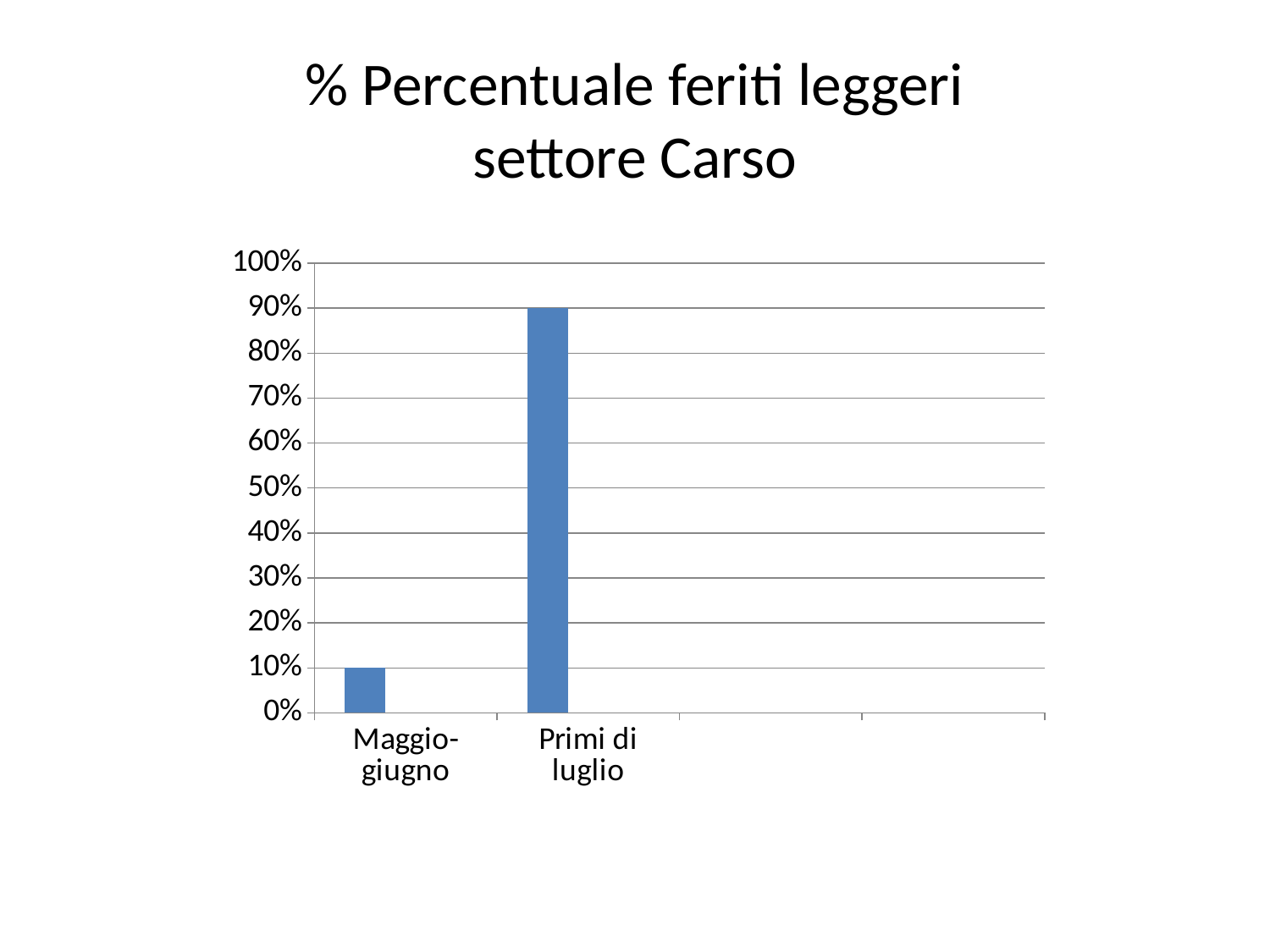
Do the values rise or fall from Maggio-giugno to Primi di luglio? rise What is the value for Primi di luglio? 90% Which category has the lowest value? Maggio-giugno Which is larger, the value for Maggio-giugno or the value for Primi di luglio? Primi di luglio What is the value for Maggio-giugno? 10% Is the value for Maggio-giugno greater or less than 20%? less What is the difference between the values for Primi di luglio and Maggio-giugno? 80% How many categories have bars in the chart? 2 Which category has the highest value? Primi di luglio What kind of chart is shown on the slide? bar chart Is the value for Primi di luglio greater or less than 50%? greater What is the title of the chart? % Percentuale feriti leggeri settore Carso